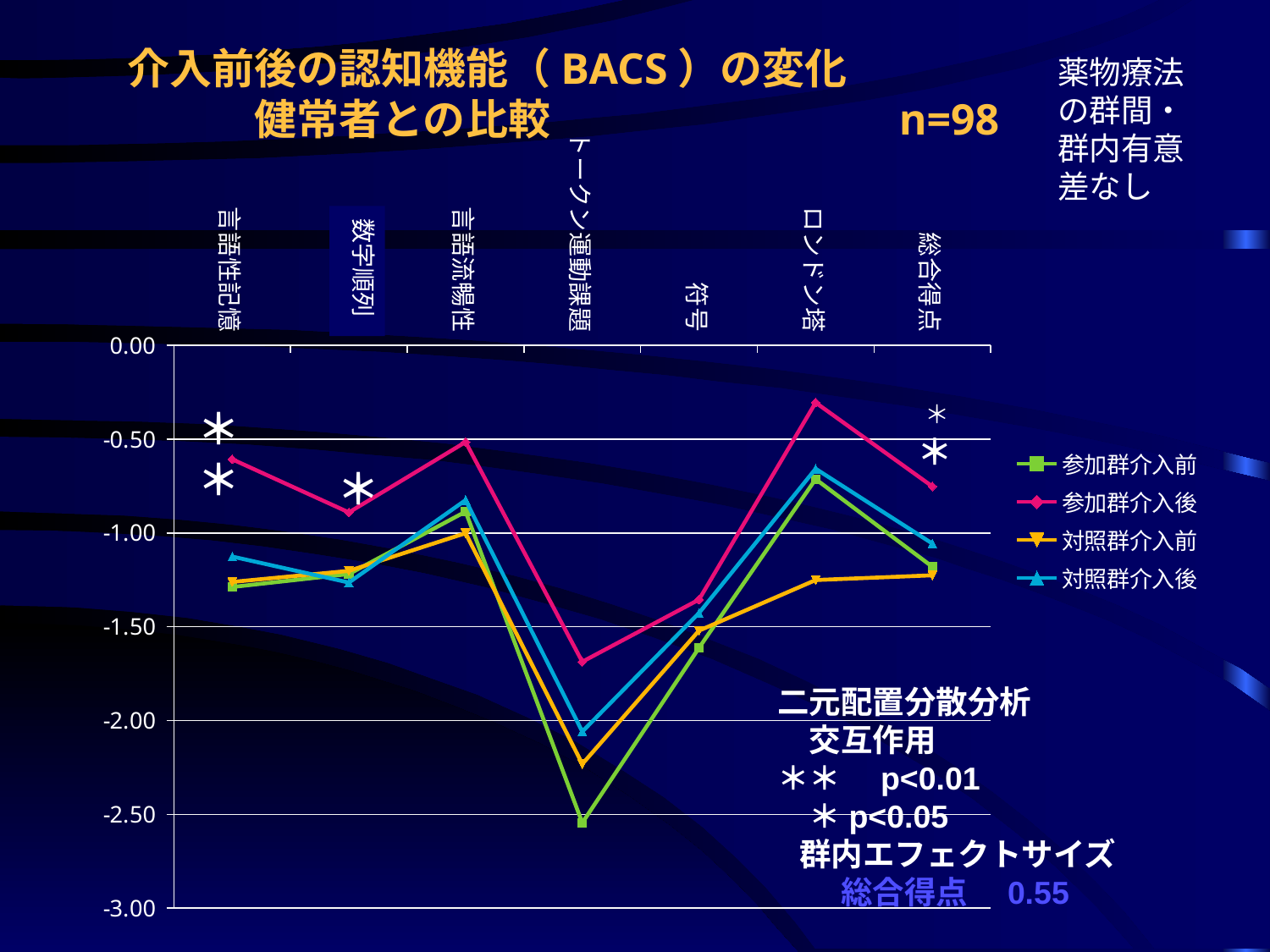
At 言語流暢性, which series has the larger value: 参加群介入後 or 対照群介入前? 参加群介入後 How many series does the chart's legend list? 4 What sample size (n) is shown on the slide? n=98 Is the value for 参加群介入前 at トークン運動課題 greater or less than -2.00? less At トークン運動課題, which series has the larger value: 参加群介入前 or 参加群介入後? 参加群介入後 What kind of chart is shown on the slide? line chart Which category has the lowest value for the 参加群介入前 series? トークン運動課題 Does the 参加群介入後 series rise or fall from 符号 to ロンドン塔? rise How many categories are plotted along the x axis of the chart? 7 Is the value for 対照群介入前 at 総合得点 greater or less than -1.00? less Is the value for 参加群介入後 at 言語性記憶 greater or less than -1.00? greater Which category has the highest value for the 参加群介入後 series? ロンドン塔